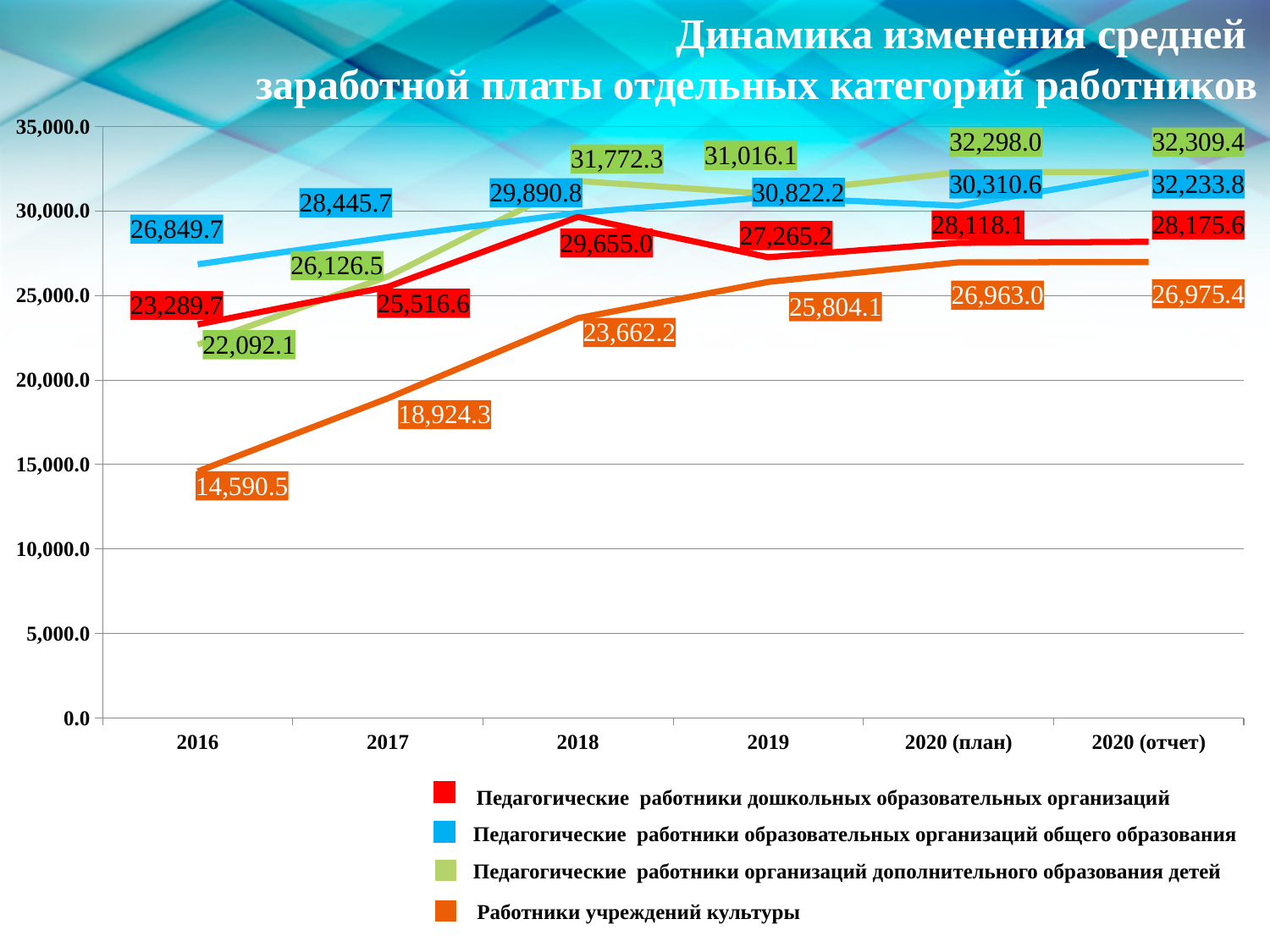
Which series has the larger value in 2017: Педагогические работники дошкольных образовательных организаций or Педагогические работники образовательных организаций общего образования? Педагогические работники образовательных организаций общего образования Which colour represents Работники учреждений культуры in the legend? Orange What type of chart is shown on the slide? Line chart How many series does the legend list? 4 Does the value for Работники учреждений культуры rise or fall from 2016 to 2019? Rise In which year is the value for Работники учреждений культуры lowest? 2016 What is the difference between the 2020 (отчет) and 2016 values for Работники учреждений культуры? 12,384.9 What is the value for Работники учреждений культуры in 2016? 14,590.5 What is the value for Педагогические работники дошкольных образовательных организаций in 2018? 29,655.0 What is the value for Педагогические работники образовательных организаций общего образования in 2020 (отчет)? 32,233.8 How many categories are shown on the x axis? 6 In which category is the value for Педагогические работники организаций дополнительного образования детей highest? 2020 (отчет)